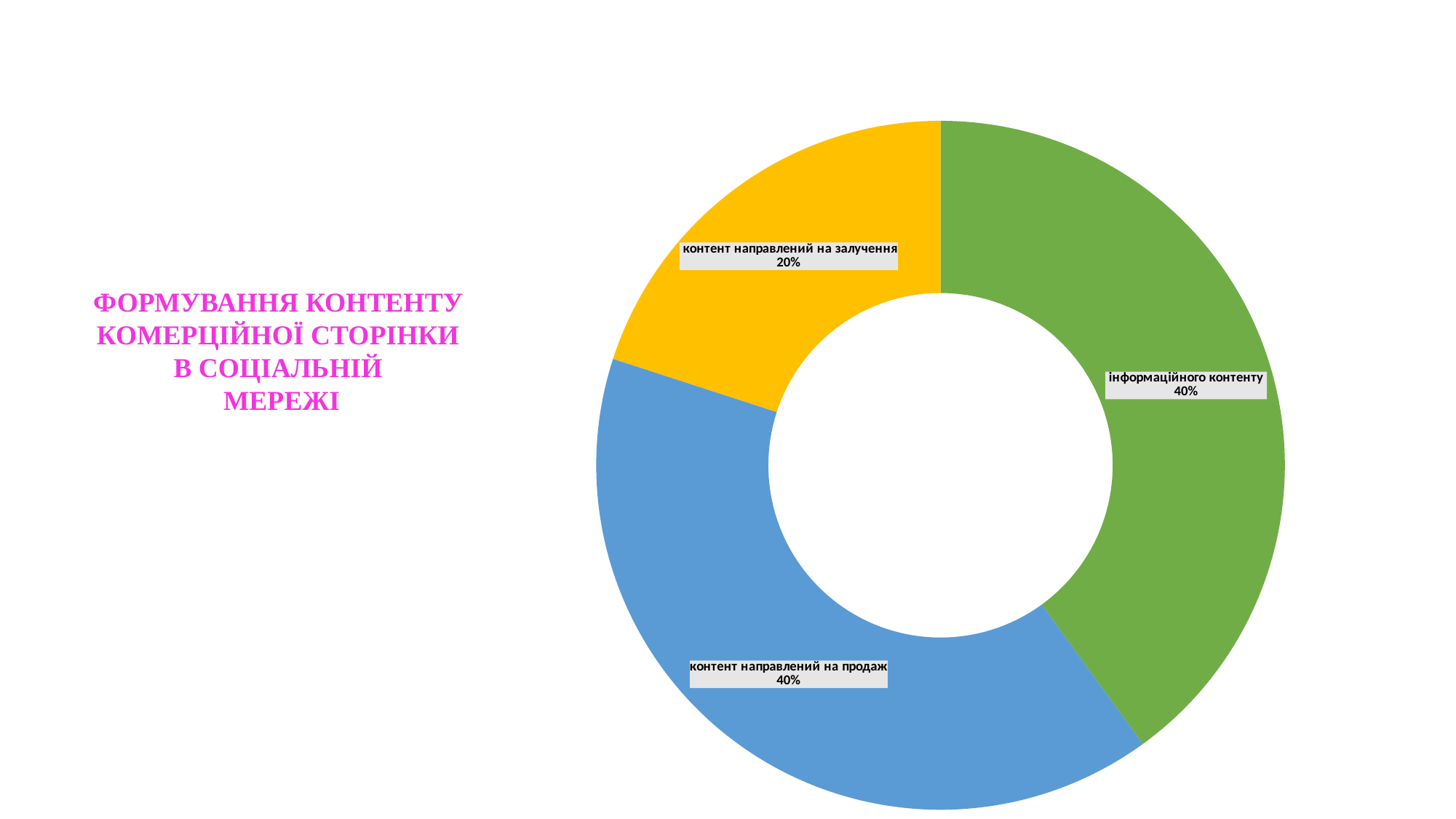
What kind of chart is shown on the slide? doughnut (pie) chart What is the difference in percentage points between "інформаційного контенту" and "контент направлений на залучення"? 20 percentage points Which is larger: the share for "контент направлений на продаж" or the share for "контент направлений на залучення"? контент направлений на продаж What percentage does the slice labelled "інформаційного контенту" represent? 40% What percentage does the slice labelled "контент направлений на продаж" represent? 40% What colour is the slice for "інформаційного контенту"? Green What percentage does the slice labelled "контент направлений на залучення" represent? 20% Which slice of the chart is the smallest? контент направлений на залучення Do the shares for "інформаційного контенту" and "контент направлений на продаж" have the same value? Yes, both are 40% What colour is the slice for "контент направлений на залучення"? Yellow What share of the whole does the "контент направлений на залучення" slice take? 20% How many slices does the chart have? 3